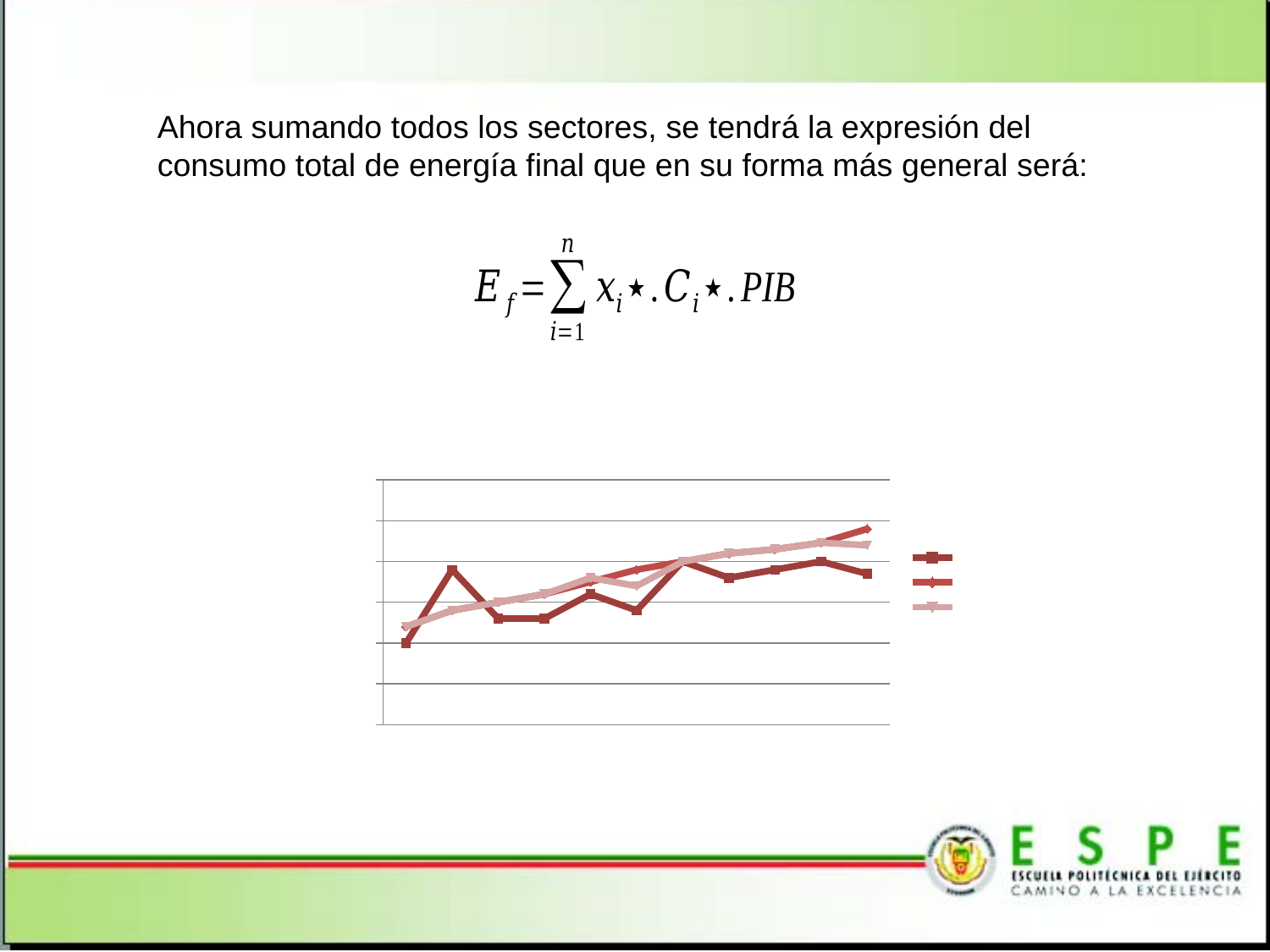
How many series does the legend of the chart list? 3 Which line starts lowest at the left-hand end of the chart: the dark red line, the medium red line, or the light pink line? the dark red line What colours are the three lines in the chart? dark red, medium red and light pink Which line ends highest at the right-hand end of the chart: the dark red line, the medium red line, or the light pink line? the medium red line Do the values of the medium red line with diamond markers generally rise or fall from left to right? rise What kind of chart is shown on the slide? line chart Do the values of the lightest (pink) line generally rise or fall from left to right? rise Does the chart have a visible title? No Which line ends lowest at the right-hand end of the chart: the dark red line, the medium red line, or the light pink line? the dark red line How many data points does each line in the chart have? 11